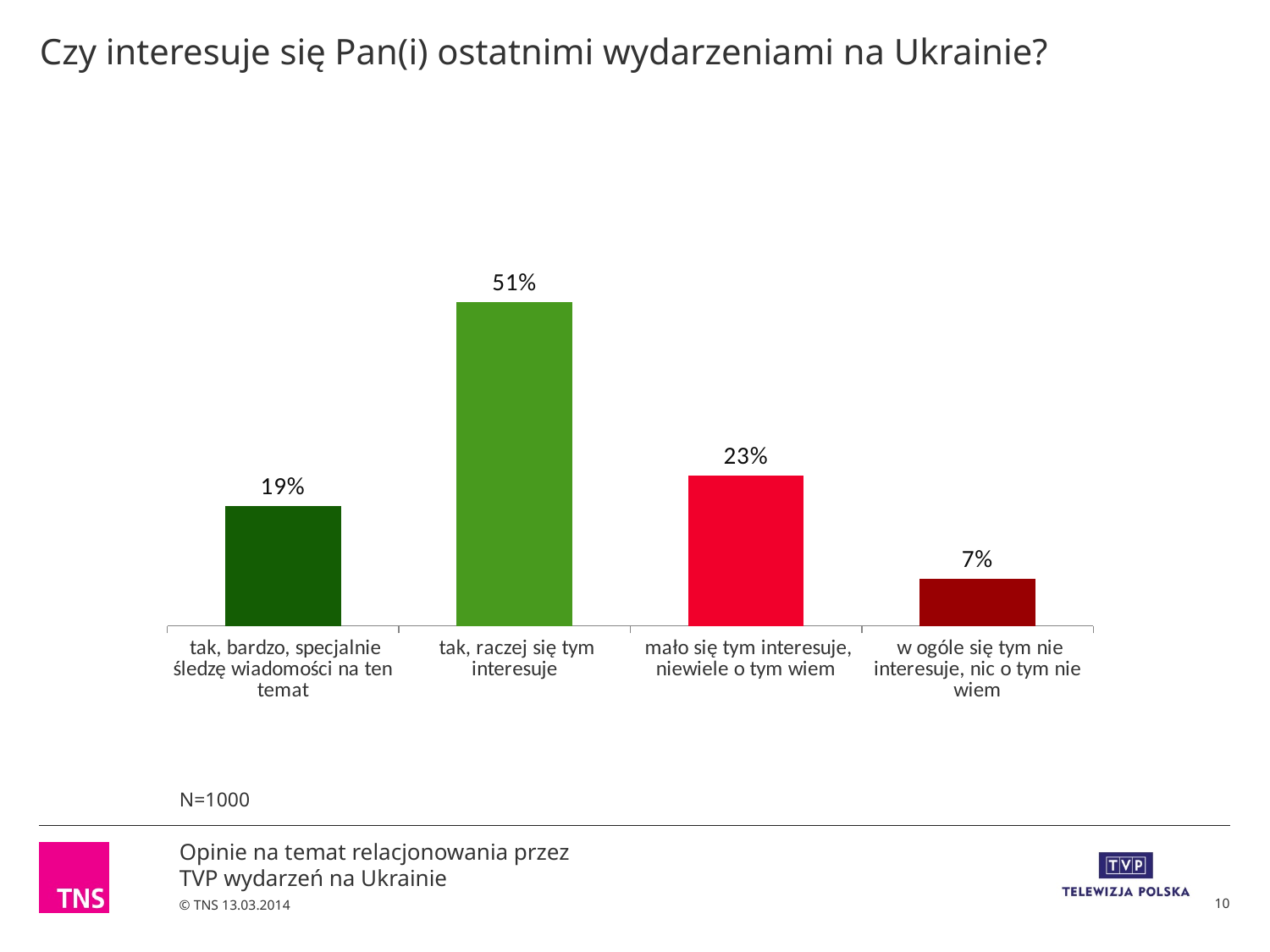
How many response categories are shown in the chart? 4 What is the value for "tak, bardzo, specjalnie śledzę wiadomości na ten temat"? 19% What is the difference between the values for "mało się tym interesuje, niewiele o tym wiem" and "tak, bardzo, specjalnie śledzę wiadomości na ten temat"? 4% What is the value for "w ogóle się tym nie interesuje, nic o tym nie wiem"? 7% Which is larger: the value for "tak, bardzo, specjalnie śledzę wiadomości na ten temat" or for "mało się tym interesuje, niewiele o tym wiem"? mało się tym interesuje, niewiele o tym wiem What kind of chart is shown on the slide? bar chart Which response category has the lowest value? w ogóle się tym nie interesuje, nic o tym nie wiem Which response category has the highest value? tak, raczej się tym interesuje What is the sample size (N) stated on the slide? N=1000 What is the difference between the values for "tak, raczej się tym interesuje" and "mało się tym interesuje, niewiele o tym wiem"? 28% What is the value for "mało się tym interesuje, niewiele o tym wiem"? 23% What percentage of respondents answered "tak, raczej się tym interesuje"? 51%